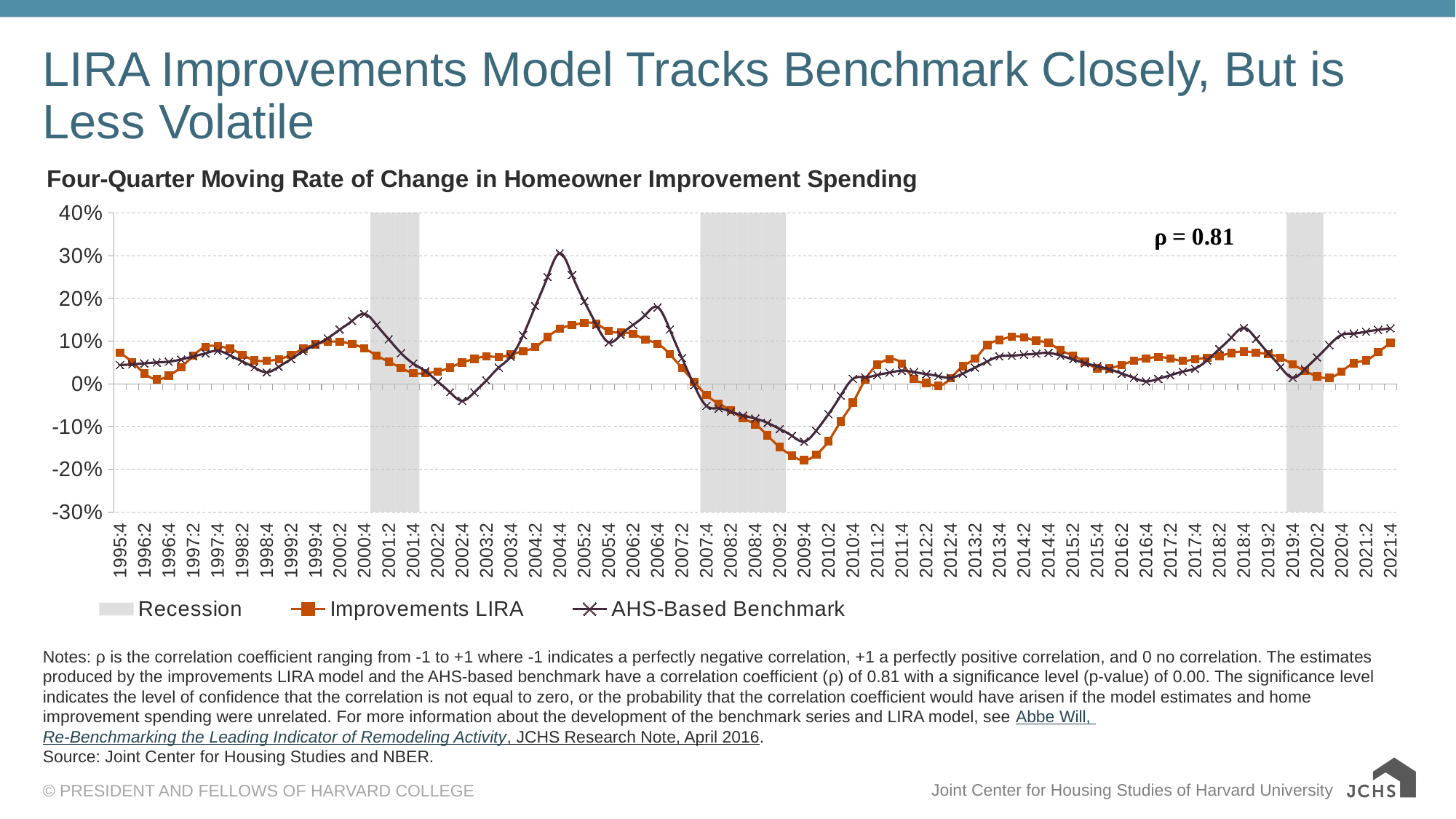
At 2004:4, which series has the larger value, Improvements LIRA or AHS-Based Benchmark? AHS-Based Benchmark Which series reaches the highest peak on the chart? AHS-Based Benchmark What is the title of the chart? Four-Quarter Moving Rate of Change in Homeowner Improvement Spending How many shaded recession periods are shown on the chart? 3 At which quarter does the Improvements LIRA series reach its lowest point? 2009:4 At 2009:4, which series has the lower value, Improvements LIRA or AHS-Based Benchmark? Improvements LIRA Does the Improvements LIRA series rise or fall between 2007:2 and 2009:4? fall What kind of chart is shown on the slide? line chart Is the AHS-Based Benchmark value at 2004:4 greater or less than 20%? greater Is the Improvements LIRA value at 2009:4 greater or less than -10%? less How many entries does the chart legend list? 3 What correlation coefficient (ρ) is printed on the chart? ρ = 0.81